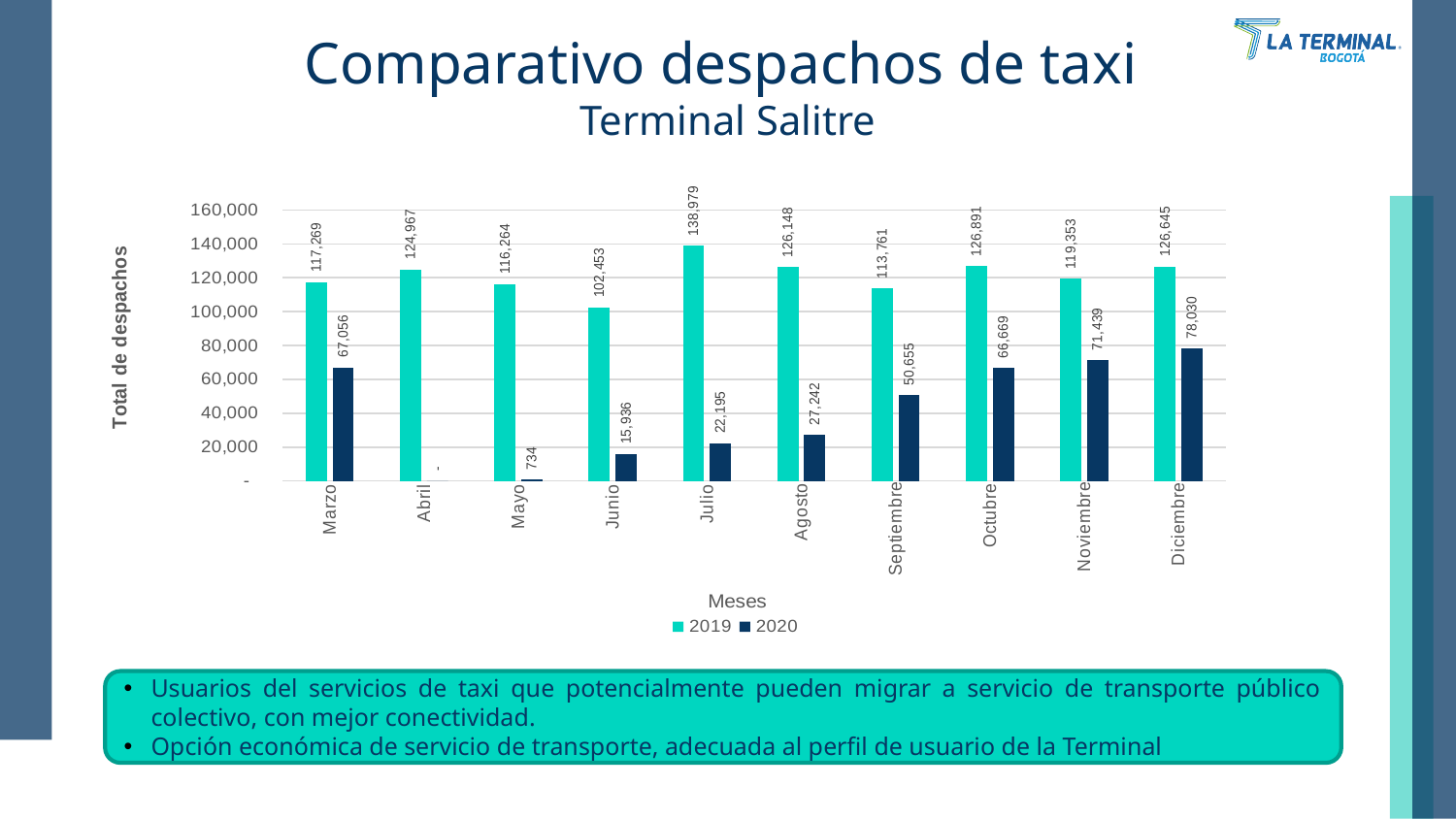
Do the 2020 values rise or fall from Mayo to Diciembre? Rise Which month has the highest value in the 2020 series? Diciembre How many series does the legend list? 2 What is the value for Septiembre in the 2020 series? 50,655 In the 2020 series, which is larger: Octubre or Noviembre? Noviembre Which month has the lowest value in the 2019 series? Junio What is the value for Mayo in the 2020 series? 734 How many months are shown on the x axis? 10 What is the difference between the 2019 and 2020 values for Marzo? 50,213 What type of chart is shown on the slide? Bar chart What is the value for Julio in the 2019 series? 138,979 Which month has the highest value in the 2019 series? Julio